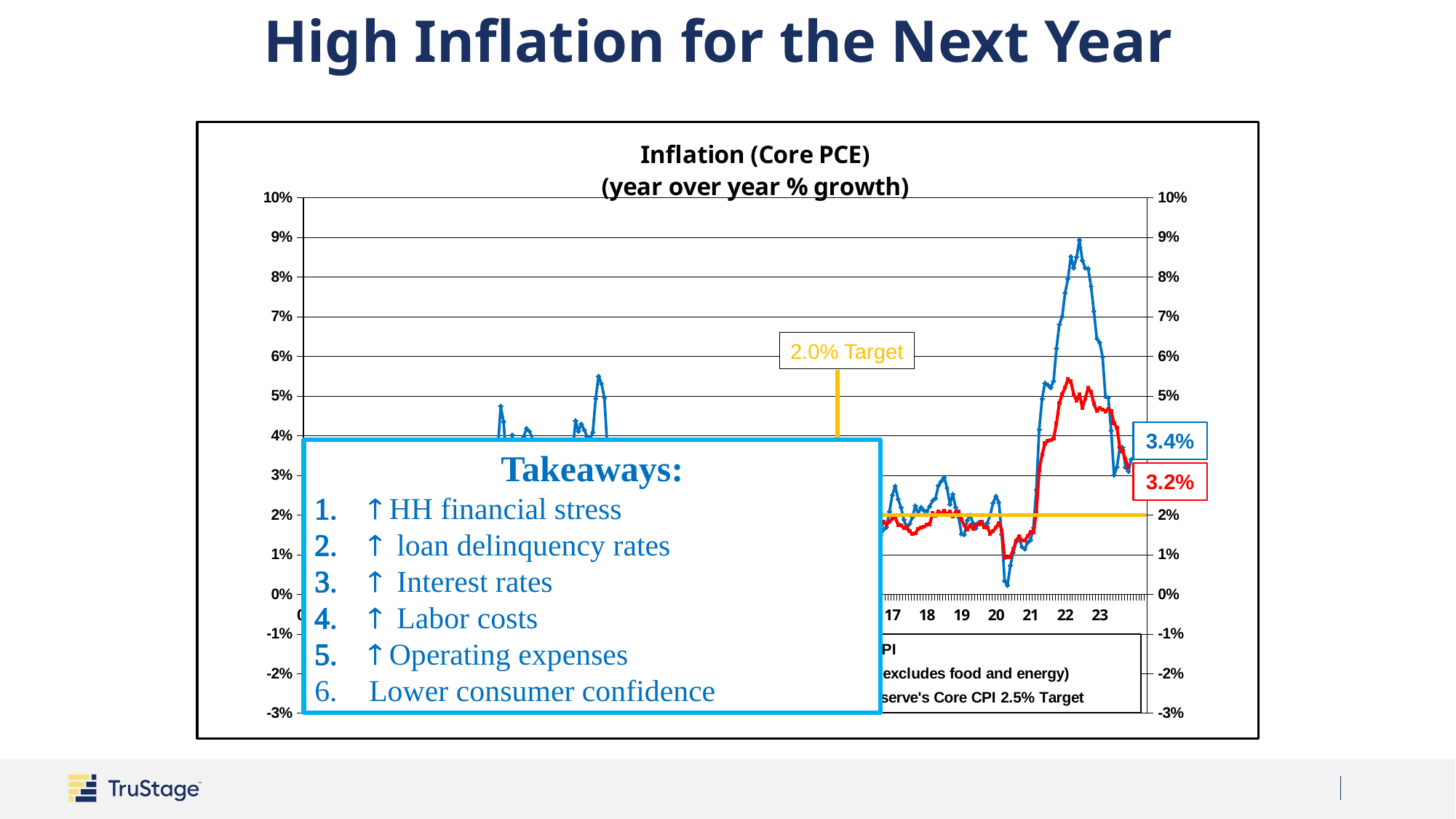
Which line has the higher latest labelled value, the blue line or the red line? blue line What kind of chart is shown on the slide? line chart Is the peak of the blue line around 2022 greater or less than 8%? greater Is the peak of the red line around 2022 greater or less than 4%? greater What target value is labelled on the horizontal reference line in the chart? 2.0% Target What is the latest value labelled for the red line? 3.2% What is the title of the chart? Inflation (Core PCE) (year over year % growth) What is the highest value shown on the chart's vertical axis? 10% From its 2022 peak to the end of the series, does the blue line rise or fall? fall What is the latest value labelled for the blue line? 3.4% What is the difference between the latest labelled values of the blue line (3.4%) and the red line (3.2%)? 0.2 percentage points Is the lowest point of the blue line around 2020 greater or less than 1%? less